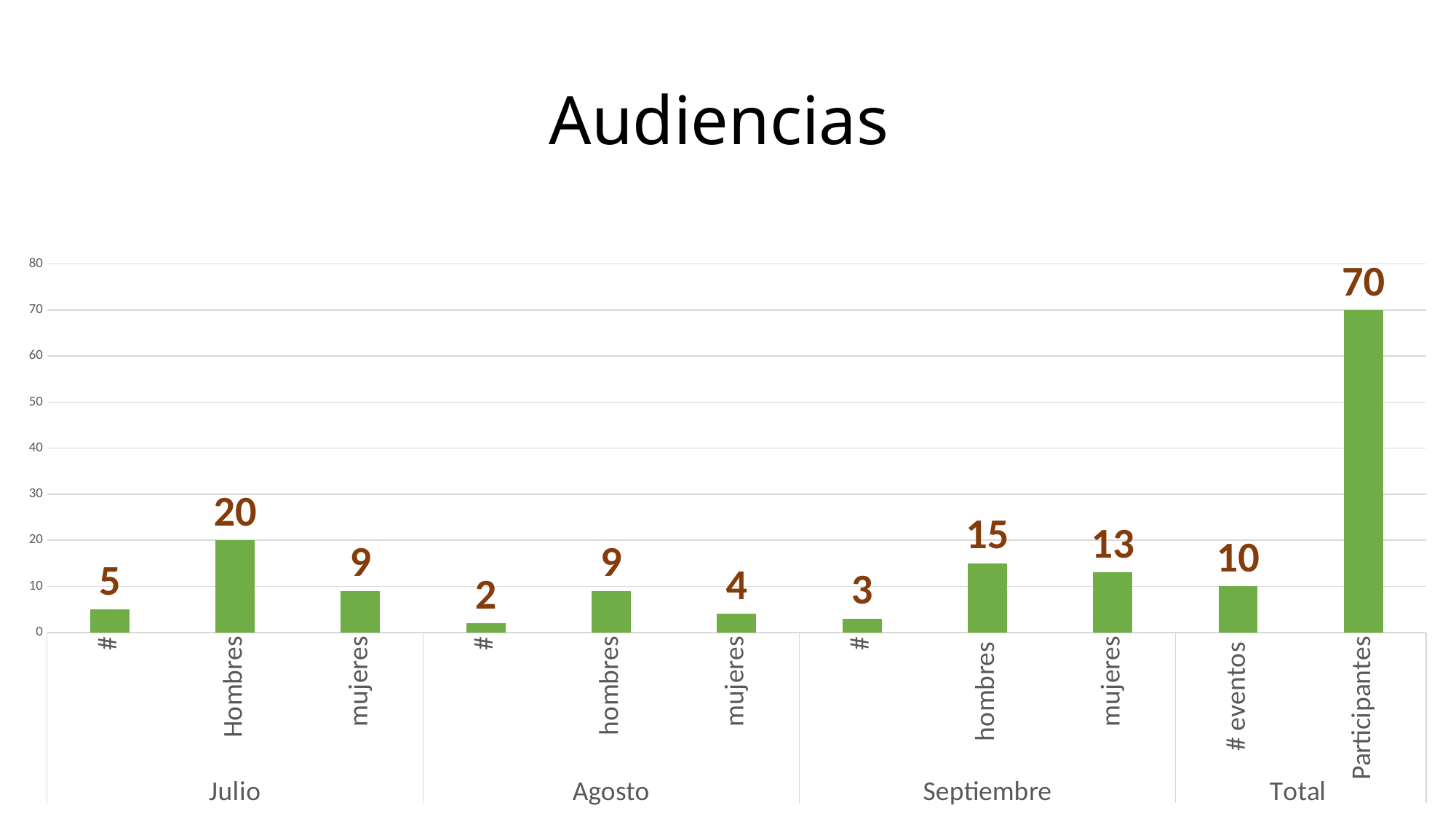
What kind of chart is shown? Bar chart What is the value for Participantes under Total? 70 What is the title of the chart? Audiencias What is the value for Hombres in Julio? 20 How many bars are plotted in the chart? 11 What is the difference between hombres and mujeres in Septiembre? 2 What is the value for # eventos under Total? 10 Is the value for Participantes greater or less than 60? greater What is the value for mujeres in Agosto? 4 Which is larger, Hombres in Julio or hombres in Septiembre? Hombres in Julio Which bar has the highest value? Participantes Which bar has the lowest value? # in Agosto